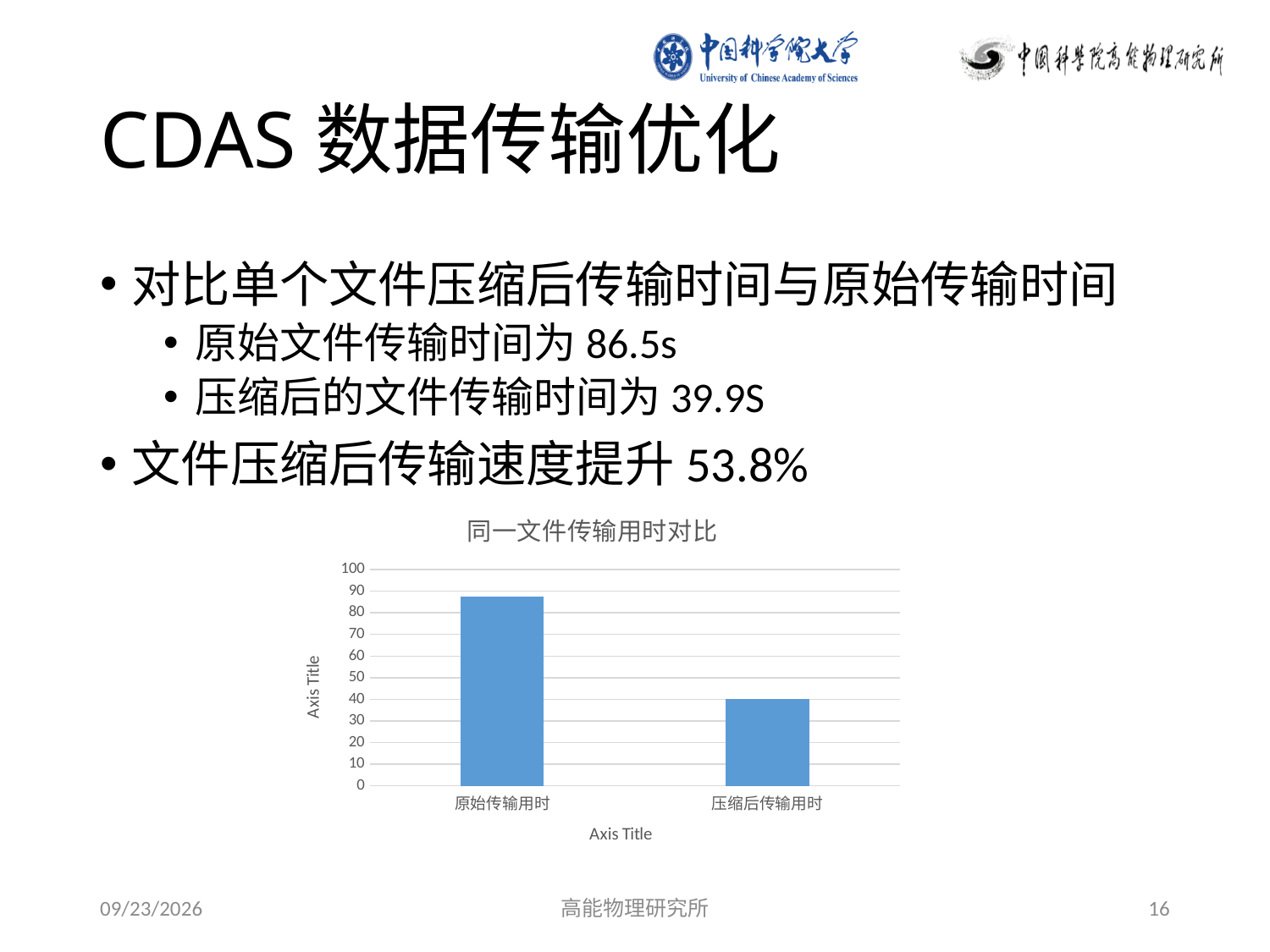
Is the value for 原始传输用时 greater or less than 80? greater Which category has the highest bar in the chart? 原始传输用时 Do the bar values rise or fall from left to right along the x axis? fall What is the title of the chart? 同一文件传输用时对比 How many bars (categories) does the chart show? 2 Which is larger, the value for 原始传输用时 or the value for 压缩后传输用时? 原始传输用时 Is the value for 压缩后传输用时 greater or less than 50? less Is the value for 压缩后传输用时 greater or less than 30? greater What kind of chart is shown on the slide? bar chart Which category has the lowest bar in the chart? 压缩后传输用时 What is the label shown on the vertical axis of the chart? Axis Title